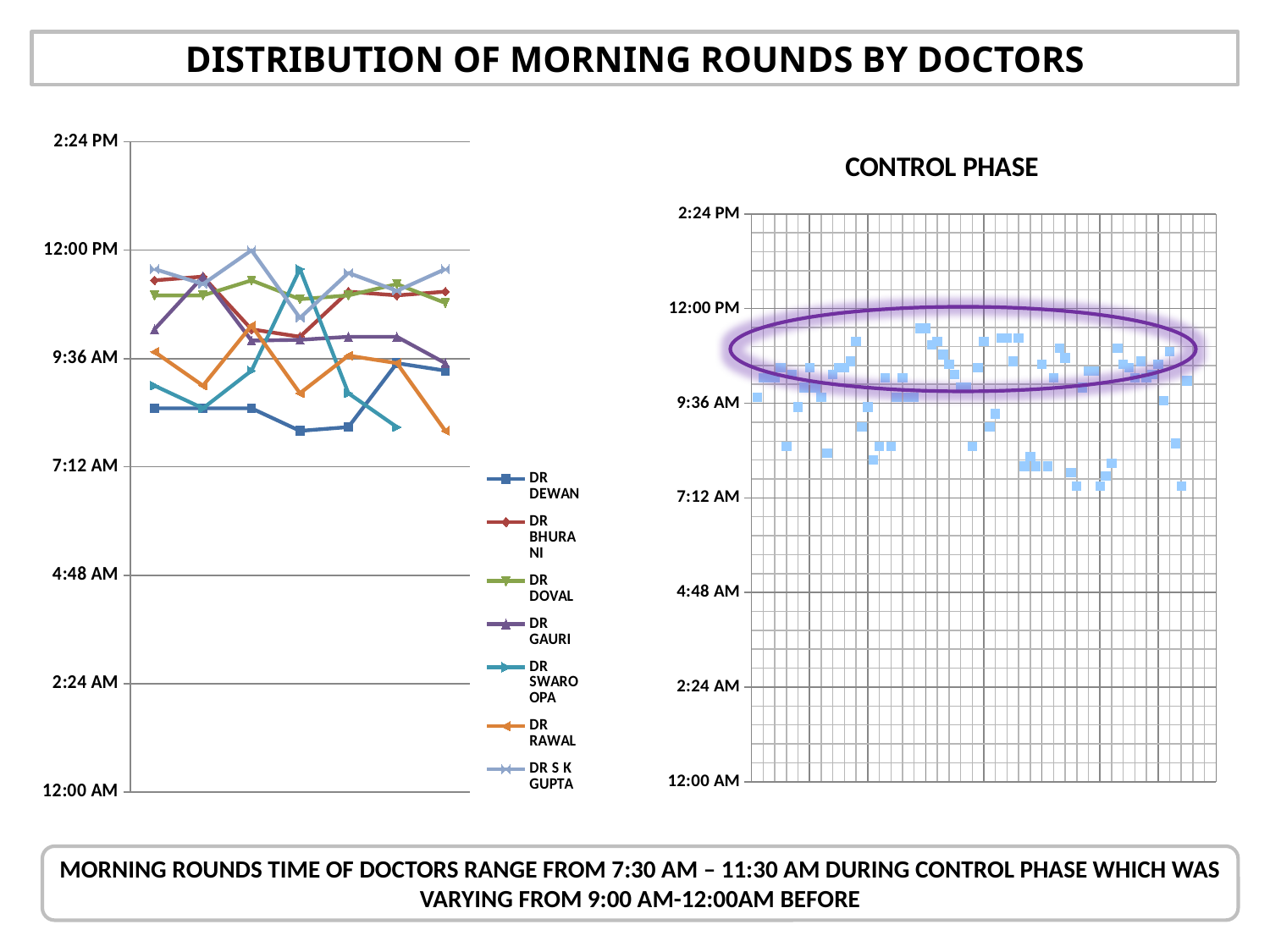
In the left chart, at the last point, which is higher: DR DOVAL or DR RAWAL? DR DOVAL In the left chart, which series is listed first in the legend? DR DEWAN What kind of chart is the chart on the left of the slide? line chart In the left chart, how many points are plotted for DR DEWAN? 7 In the left chart, which series reaches the highest point on the chart? DR S K GUPTA In the left chart, at the first point, which is higher: DR S K GUPTA or DR DEWAN? DR S K GUPTA In the left chart, is the third value for DR S K GUPTA greater or less than 9:36 AM? greater What kind of chart is the CONTROL PHASE chart on the right? scatter chart How many series does the legend of the left chart list? 7 What is the title of the chart on the right of the slide? CONTROL PHASE In the CONTROL PHASE chart, is the highest plotted point greater or less than 12:00 PM? less In the left chart, is the first value for DR DEWAN greater or less than 9:36 AM? less